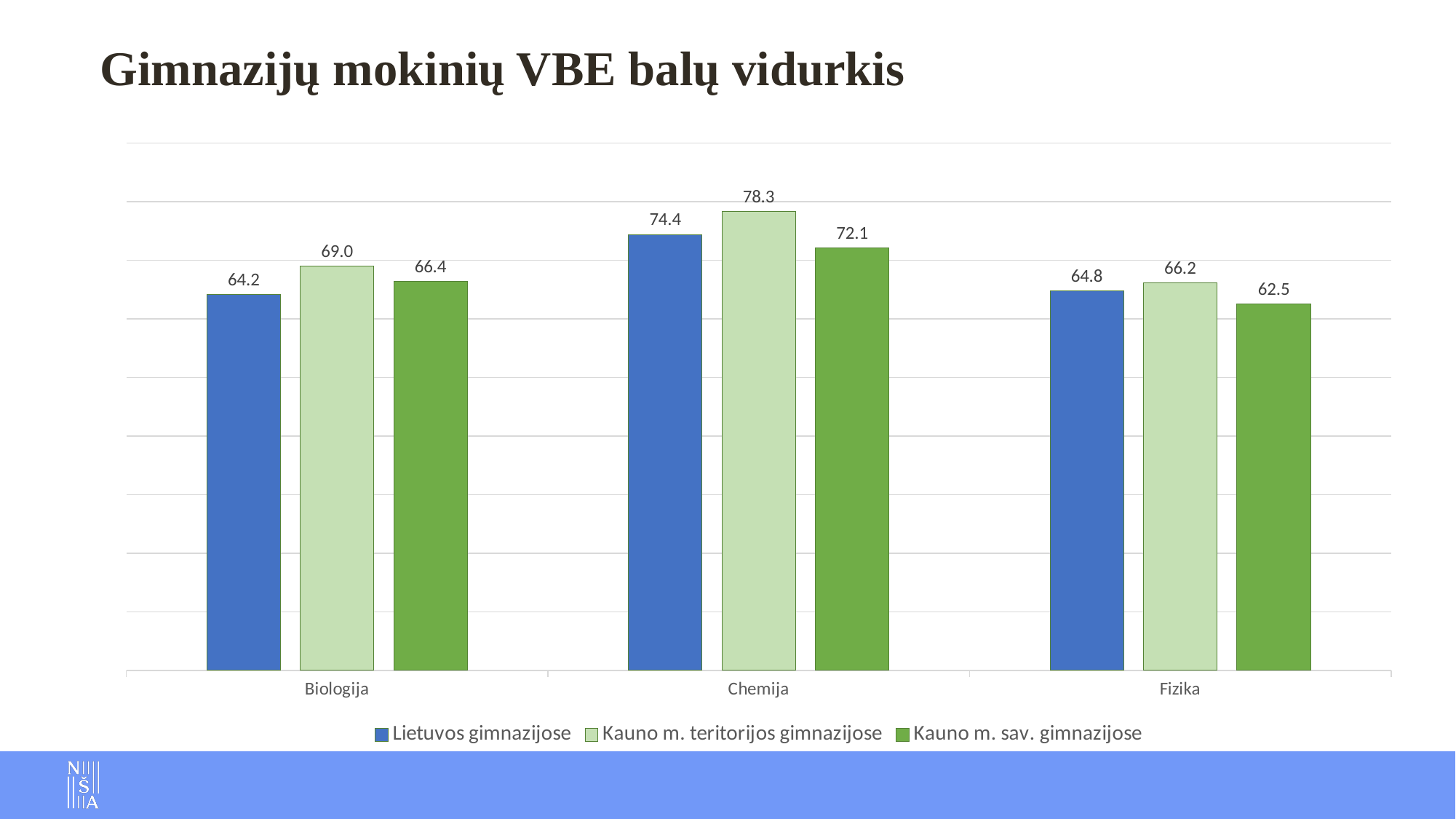
In Fizika, which is larger: Lietuvos gimnazijose or Kauno m. sav. gimnazijose? Lietuvos gimnazijose How many series does the legend list? 3 What is the difference between Kauno m. sav. gimnazijose and Lietuvos gimnazijose in Biologija? 2.2 How many subject categories are shown on the x axis? 3 What is the value for Kauno m. sav. gimnazijose in Fizika? 62.5 What is the value for Lietuvos gimnazijose in Chemija? 74.4 Which subject has the highest value for Kauno m. teritorijos gimnazijose? Chemija What is the difference between Kauno m. teritorijos gimnazijose and Lietuvos gimnazijose in Chemija? 3.9 What kind of chart is shown on the slide? bar chart Which subject has the lowest value for Kauno m. sav. gimnazijose? Fizika What is the title of the chart on the slide? Gimnazijų mokinių VBE balų vidurkis What is the value for Kauno m. teritorijos gimnazijose in Biologija? 69.0